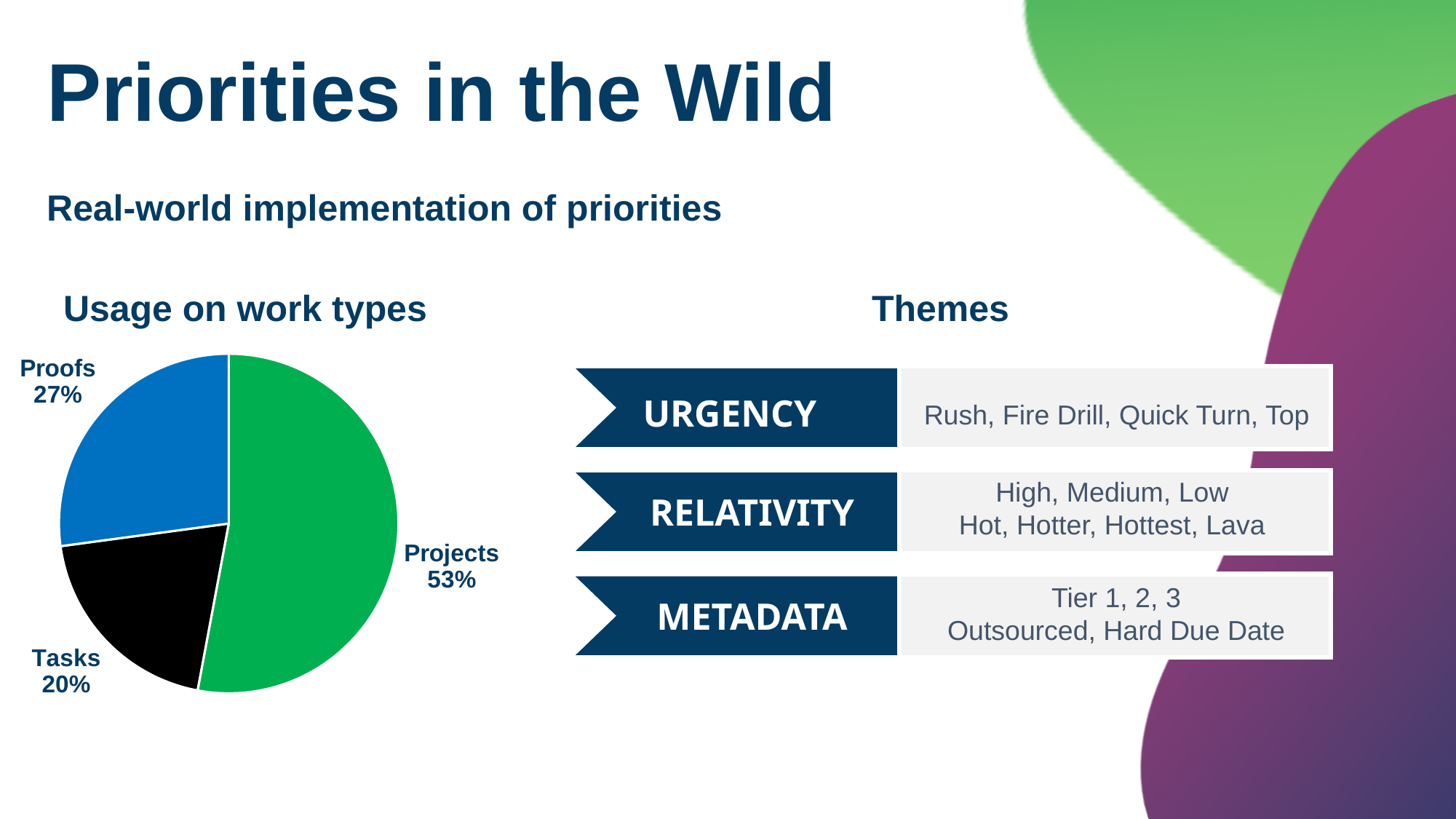
Which is larger in the pie chart, Proofs or Tasks? Proofs What is the difference in percentage points between Projects and Proofs? 26 Which work type has the smallest slice of the pie chart? Tasks How many slices does the pie chart have? 3 What share of the pie chart is Projects? 53% Which work type has the largest slice of the pie chart? Projects What is the difference in percentage points between Proofs and Tasks? 7 What share of the pie chart is Proofs? 27% What kind of chart is shown under "Usage on work types"? Pie chart What colour is the Projects slice of the pie chart? Green What is the title of the pie chart? Usage on work types What share of the pie chart is Tasks? 20%